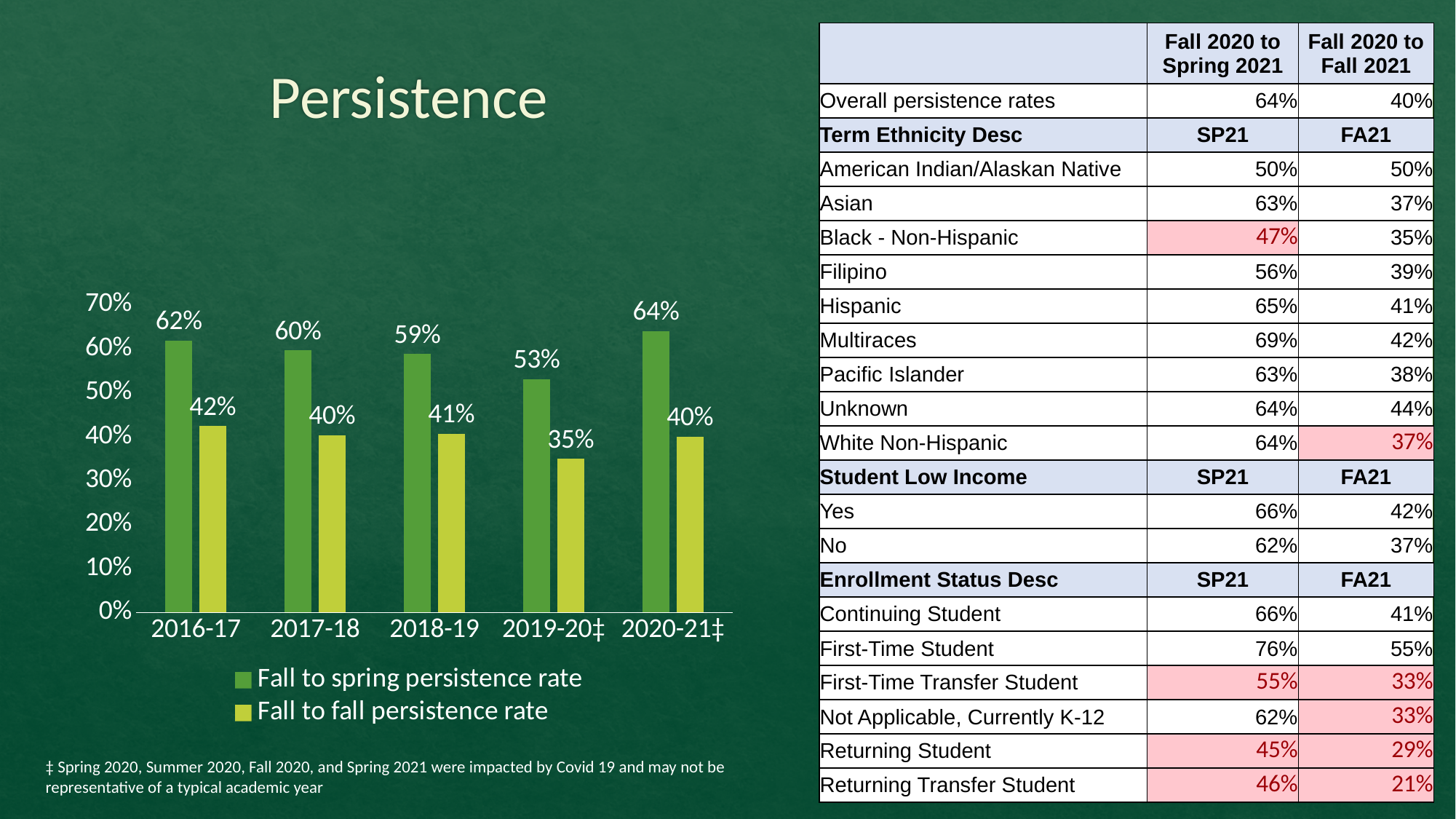
What is the fall to fall persistence rate for 2019-20‡? 35% Which is larger, the fall to fall persistence rate for 2016-17 or for 2017-18? 2016-17 What kind of chart is shown on the slide? Bar chart What is the difference between the fall to spring and fall to fall persistence rates in 2018-19? 18% Which year has the highest fall to spring persistence rate? 2020-21‡ Is the fall to spring persistence rate for 2019-20‡ greater or less than 50%? greater Which year has the lowest fall to fall persistence rate? 2019-20‡ How many academic years are shown on the x axis of the chart? 5 What is the fall to spring persistence rate for 2016-17? 62% What is the fall to spring persistence rate for 2020-21‡? 64% How many series does the chart legend list? 2 Which series is shown in the lighter yellow-green colour in the chart? Fall to fall persistence rate